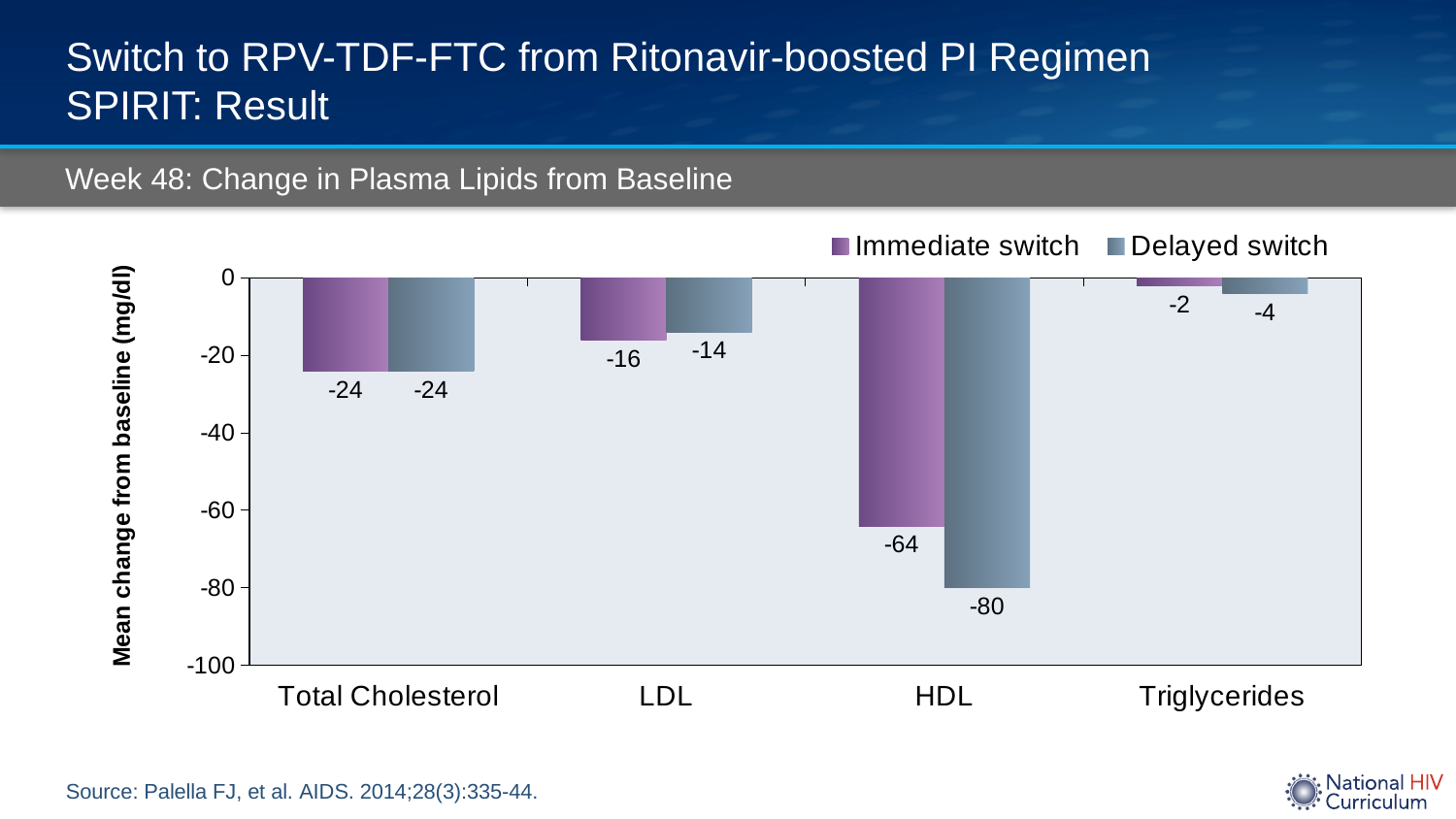
What is the value for Immediate switch for Total Cholesterol? -24 How many series does the legend list? 2 What is the value for Delayed switch for Triglycerides? -4 Which category has the lowest (most negative) value for Delayed switch? HDL What is the difference between the Immediate switch and Delayed switch values for HDL? 16 Which category has the highest (least negative) value for Immediate switch? Triglycerides For HDL, which series has the larger (less negative) value, Immediate switch or Delayed switch? Immediate switch What kind of chart is shown on the slide? Bar chart What is the value for Delayed switch for HDL? -80 What is the value for Immediate switch for LDL? -16 How many categories are shown on the x axis? 4 What is the difference between the Immediate switch and Delayed switch values for LDL? 2